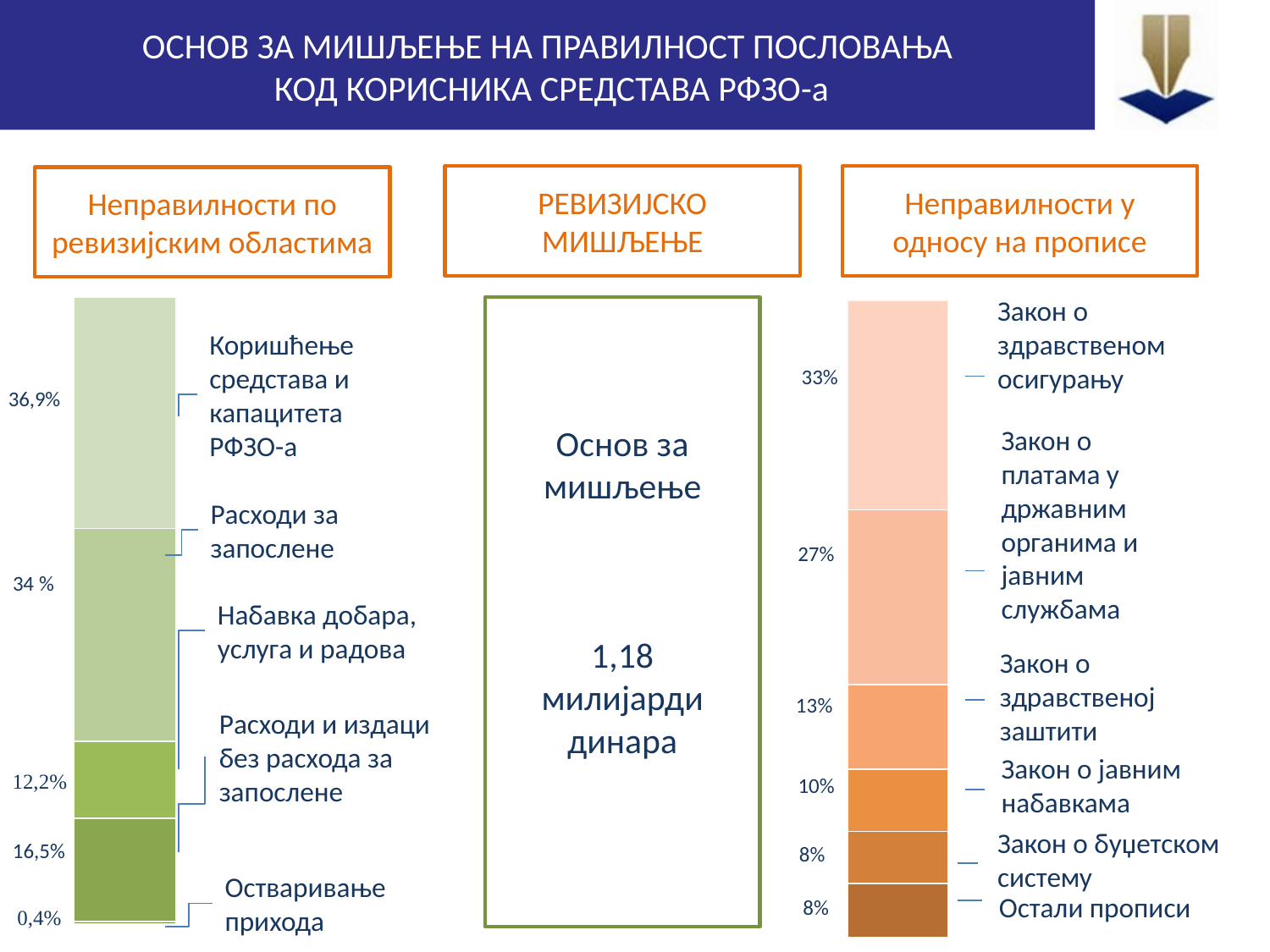
How many segments does the stacked bar in the chart 'Неправилности по ревизијским областима' have? 5 In the chart 'Неправилности у односу на прописе', which is larger: 'Закон о здравственој заштити' or 'Закон о јавним набавкама'? Закон о здравственој заштити In the chart 'Неправилности по ревизијским областима', what is the value for 'Остваривање прихода'? 0,4% What type of chart is 'Неправилности по ревизијским областима'? Stacked bar chart In the chart 'Неправилности у односу на прописе', what is the value for 'Закон о јавним набавкама'? 10% In the chart 'Неправилности по ревизијским областима', what is the smallest value shown? 0,4% In the chart 'Неправилности у односу на прописе', what is the difference between 'Закон о здравственом осигурању' and 'Закон о платама у државним органима и јавним службама'? 6 percentage points In the chart 'Неправилности у односу на прописе', what is the value for 'Закон о здравственом осигурању'? 33% In the chart 'Неправилности у односу на прописе', what is the value for 'Закон о здравственој заштити'? 13% In the chart 'Неправилности по ревизијским областима', what is the value for 'Коришћење средстава и капацитета РФЗО-а'? 36,9% In the chart 'Неправилности у односу на прописе', which category has the highest value? Закон о здравственом осигурању How many segments does the stacked bar in the chart 'Неправилности у односу на прописе' have? 6